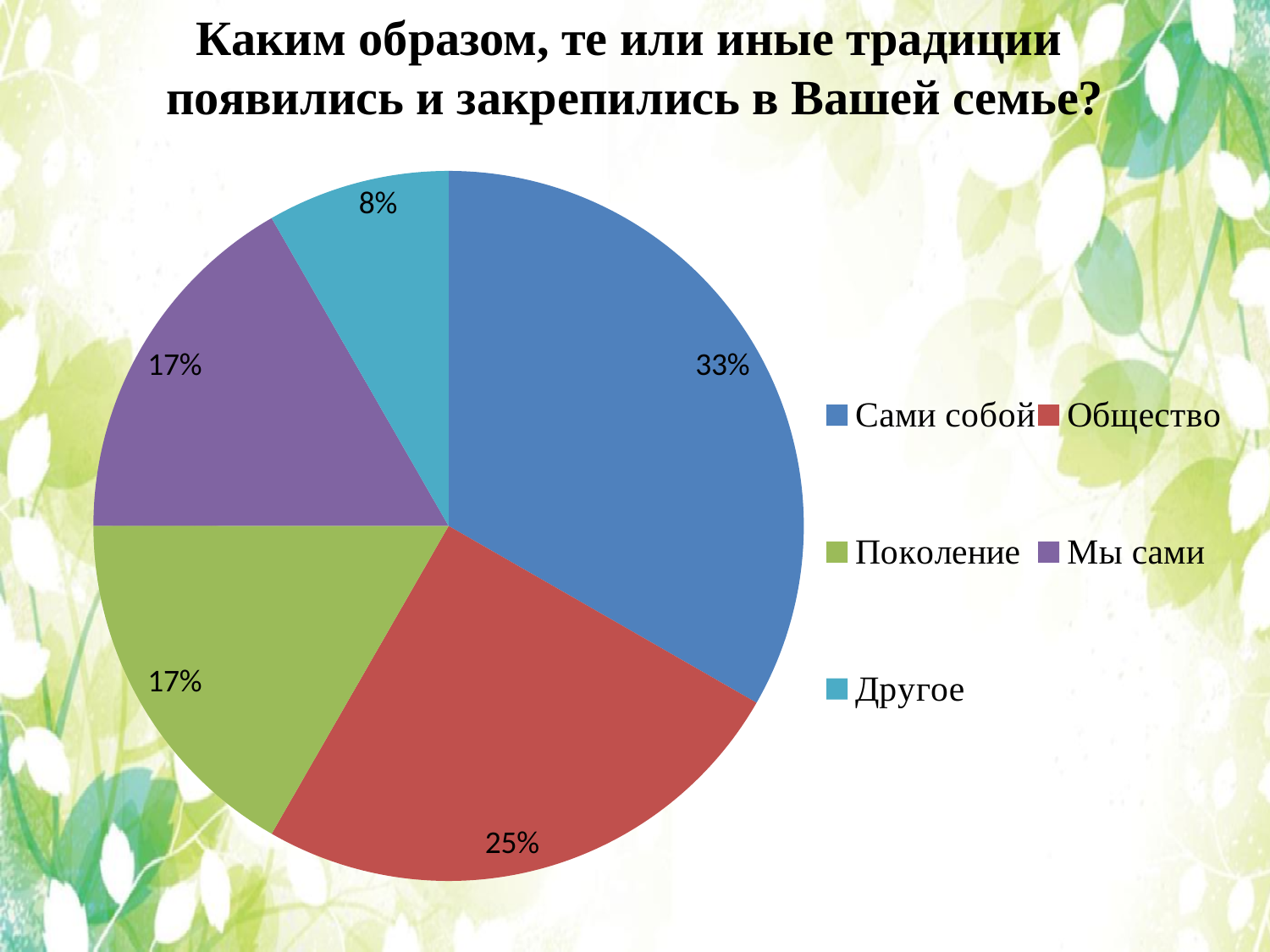
What colour is the slice for "Поколение"? green What is the value shown for "Другое"? 8% What kind of chart is shown on the slide? pie chart What share of the pie does "Сами собой" take? 33% What is the difference between the shares of "Сами собой" and "Общество"? 8% What is the value shown for "Поколение"? 17% What is the difference between the shares of "Мы сами" and "Другое"? 9% Which category has the largest slice of the pie? Сами собой Which category has the smallest slice of the pie? Другое Which is larger, the share for "Общество" or the share for "Мы сами"? Общество How many slices does the pie chart have? 5 What is the value shown for "Общество"? 25%